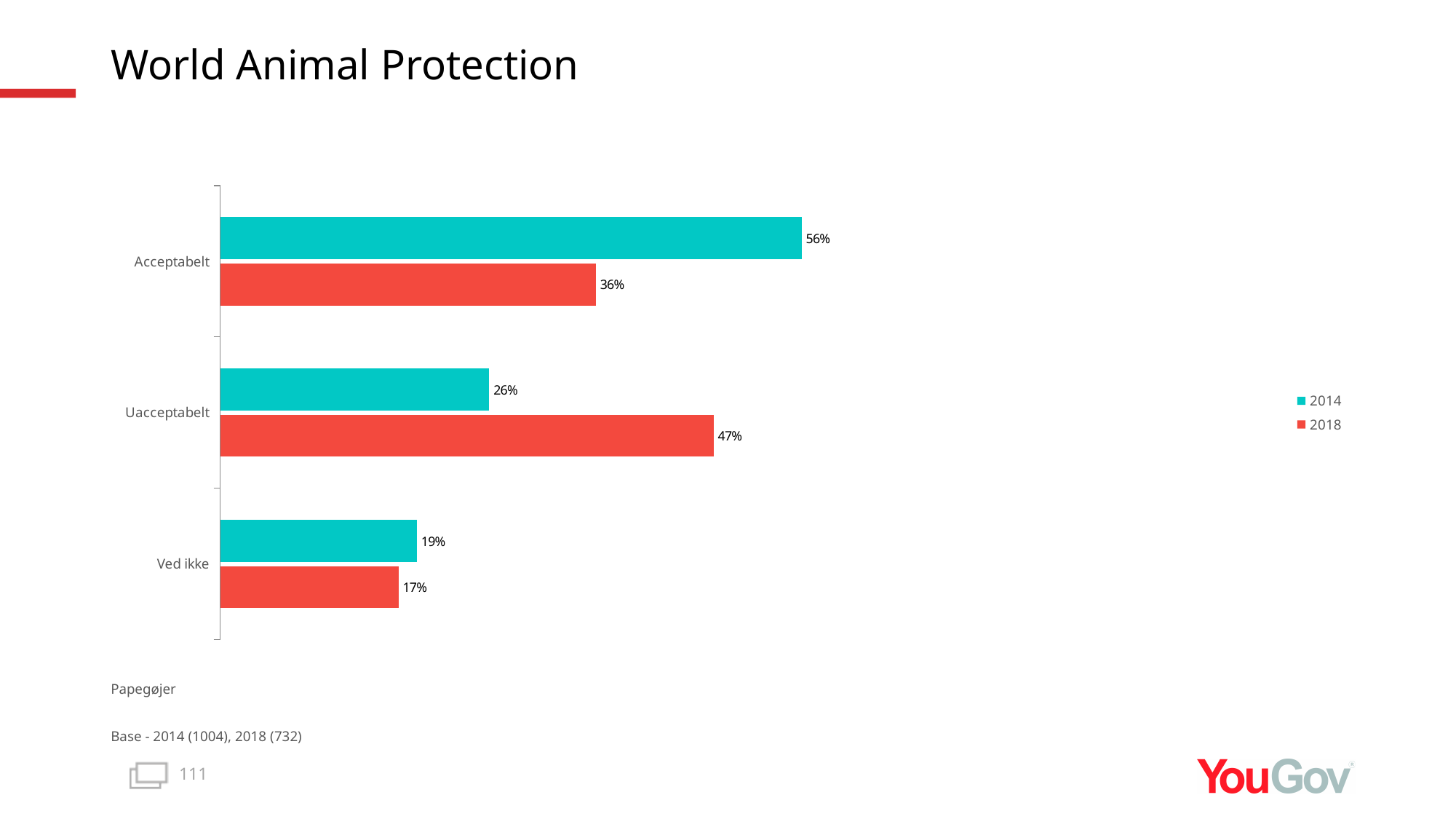
How many categories are shown on the chart? 3 Which colour represents the 2018 series? Red What is the difference between the 2014 and 2018 values for Acceptabelt? 20 percentage points Which is larger for Uacceptabelt, the 2014 value or the 2018 value? 2018 How many series does the legend list? 2 What is the 2018 value for Ved ikke? 17% What is the 2018 value for Uacceptabelt? 47% Which category has the highest 2018 value? Uacceptabelt What kind of chart is shown on the slide? Bar chart What is the difference between the 2014 and 2018 values for Ved ikke? 2 percentage points What is the 2014 value for Acceptabelt? 56% Which category has the lowest 2014 value? Ved ikke